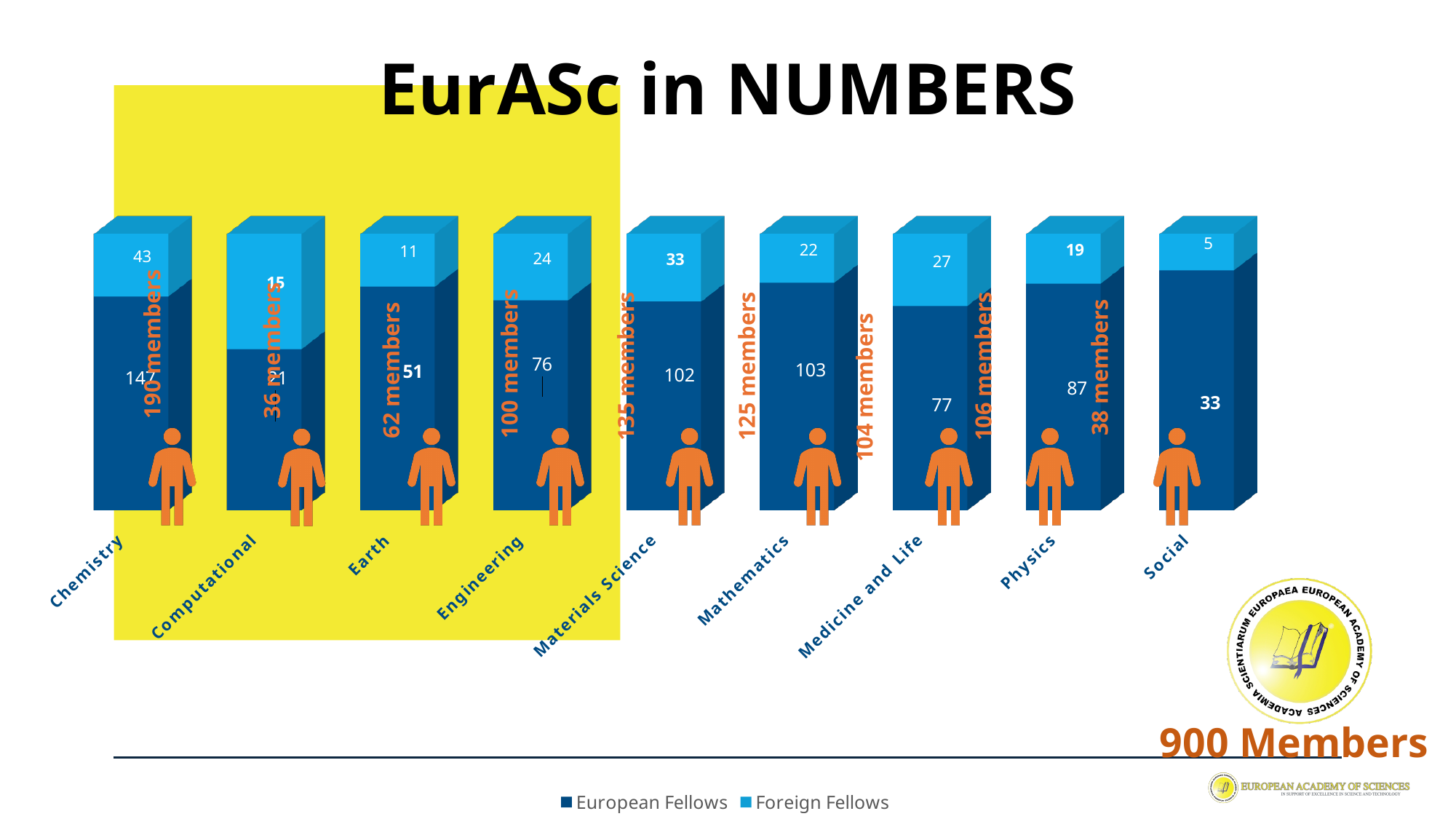
How many categories are shown on the chart? 9 What is the difference between the European Fellows in Chemistry and in Physics? 60 Which has more Foreign Fellows, Materials Science or Mathematics? Materials Science What kind of chart is shown on the slide? Stacked bar chart Which category has the lowest number of Foreign Fellows? Social How many European Fellows are shown for Chemistry? 147 Which category has the highest number of European Fellows? Chemistry What is the total number of fellows (European plus Foreign) for Social? 38 What is the title of the slide? EurASc in NUMBERS How many European Fellows are shown for Mathematics? 103 How many series does the legend list? 2 How many Foreign Fellows are shown for Engineering? 24